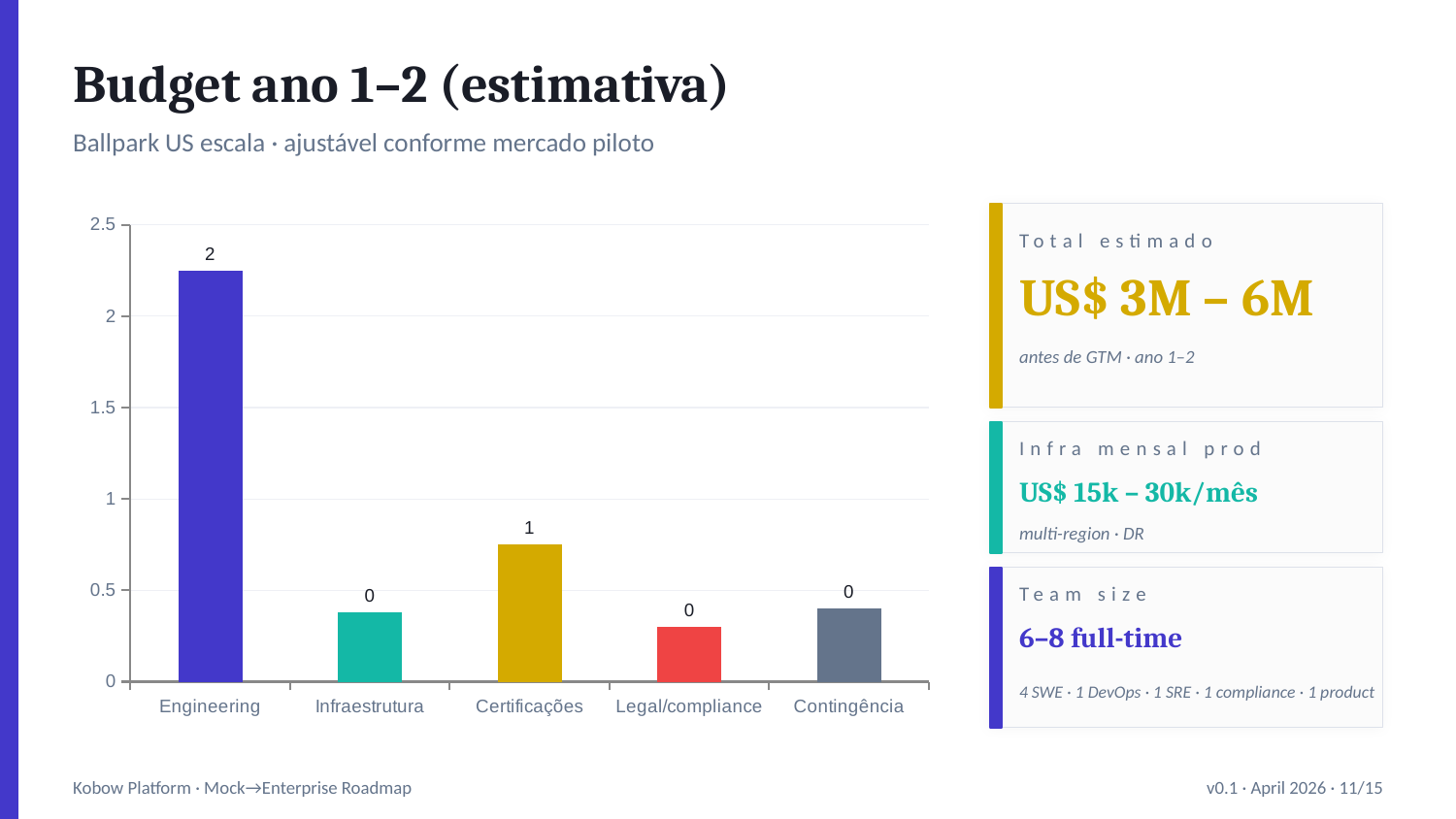
What type of chart is shown on the slide? bar chart What data label is printed above the Engineering bar? 2 Which category has the highest bar in the chart? Engineering Is the value for Certificações greater or less than 1? less Is the value for Infraestrutura greater or less than 0.5? less How many categories are shown on the x axis of the chart? 5 Is the value for Engineering greater or less than 2? greater Which is larger, the bar for Certificações or the bar for Infraestrutura? Certificações What is the title of the slide containing the chart? Budget ano 1–2 (estimativa) What data label is printed above the Certificações bar? 1 Which is larger, the bar for Contingência or the bar for Legal/compliance? Contingência Which category has the lowest bar in the chart? Legal/compliance